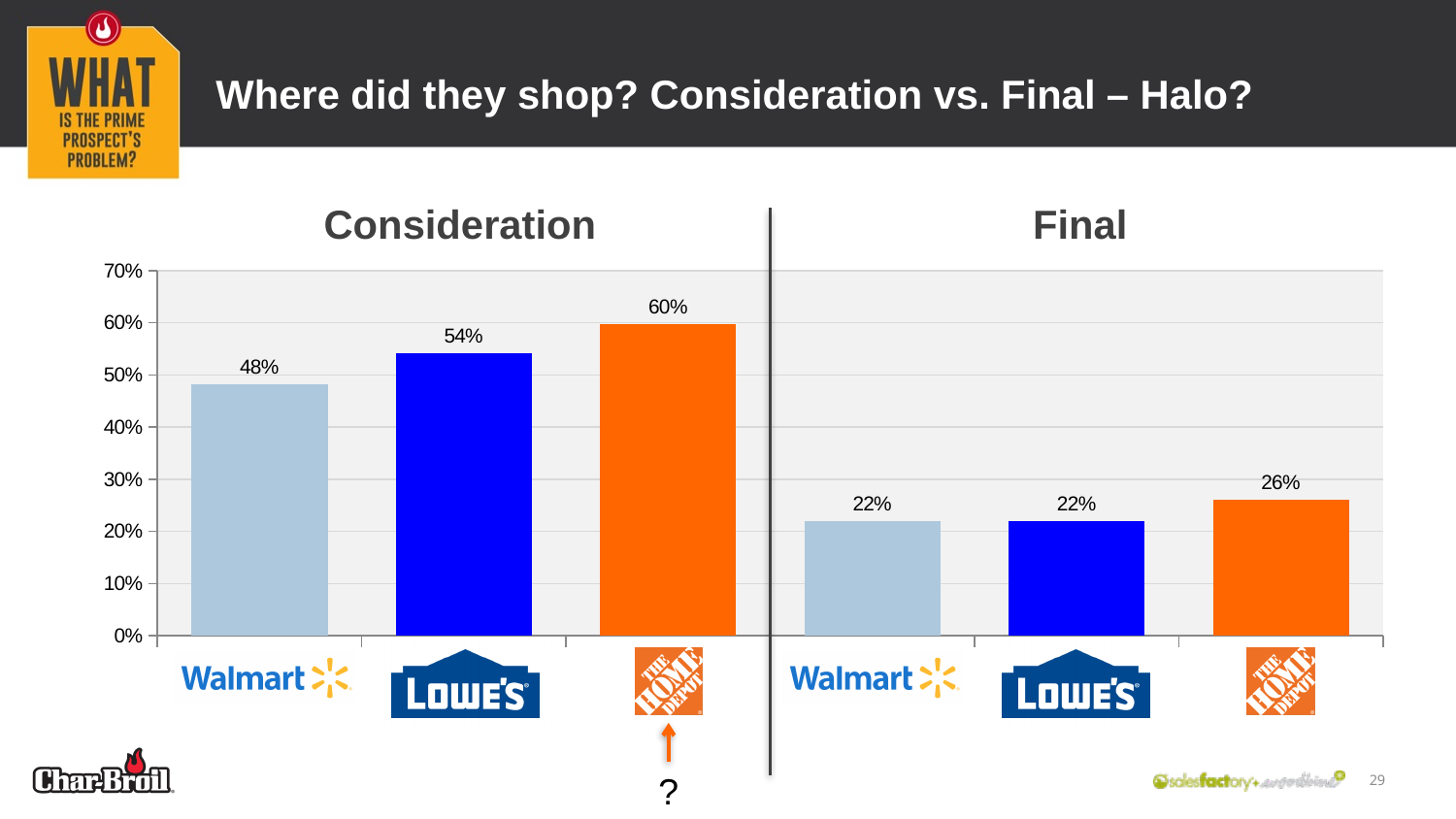
What is the difference between Home Depot's Consideration value and its Final value? 34% Is the Final value for Home Depot greater or less than 30%? less Which retailer has the highest Consideration value? Home Depot What is the Consideration value for Lowe's? 54% How many bars are plotted in the chart in total? 6 Which is larger: Lowe's Consideration value or Walmart's Consideration value? Lowe's What kind of chart is shown on the slide? bar chart Which retailer has the lowest Consideration value? Walmart What is the Consideration value for Home Depot? 60% What is the difference between Lowe's and Walmart in the Consideration group? 6% Which retailer has the highest Final value? Home Depot What is the Final value for Walmart? 22%